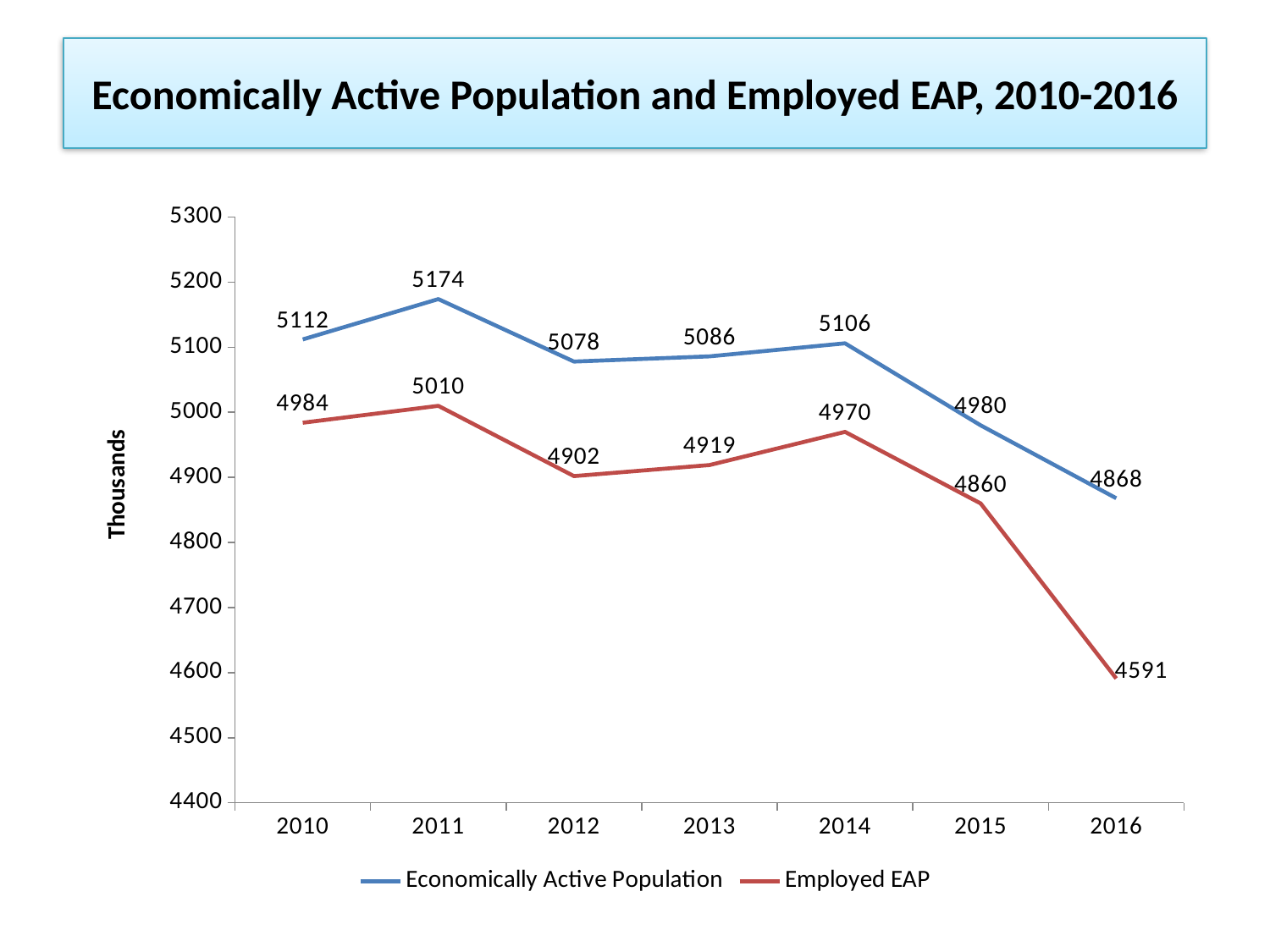
What kind of chart is shown on the slide? line chart How many series does the legend list? 2 What is the Employed EAP value for 2016? 4591 What is the label on the vertical axis? Thousands What is the Employed EAP value for 2013? 4919 How many years are plotted on the x axis? 7 What is the Economically Active Population value for 2011? 5174 What is the difference between the Economically Active Population and the Employed EAP in 2016? 277 What is the difference between the Employed EAP in 2015 and in 2016? 269 Which is larger: the Economically Active Population in 2012 or in 2014? 2014 In which year is the Employed EAP lowest? 2016 In which year is the Economically Active Population highest? 2011